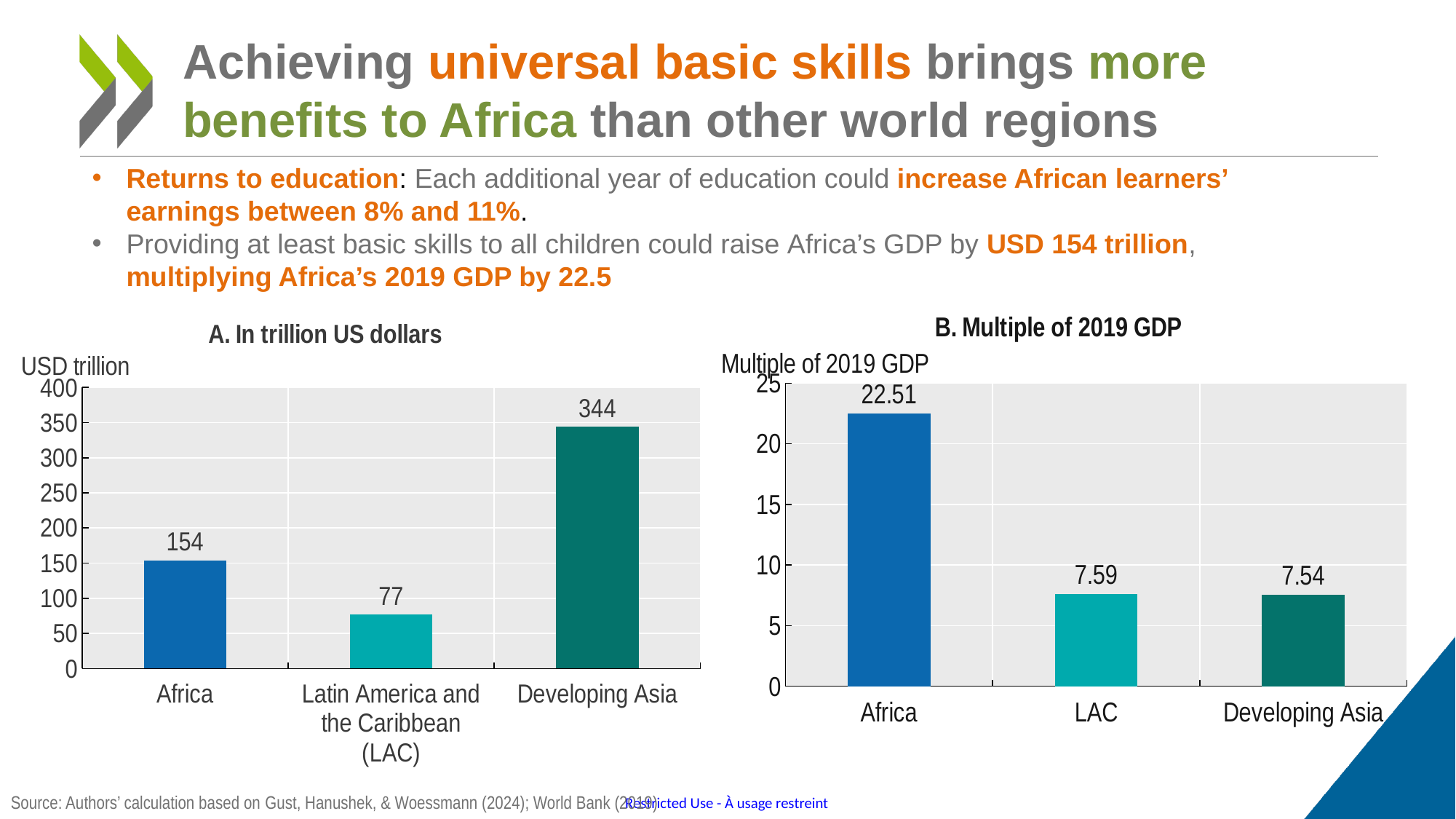
In chart A (In trillion US dollars), what is the value for Developing Asia? 344 In chart B (Multiple of 2019 GDP), what is the value for LAC? 7.59 In chart A (In trillion US dollars), what is the value for Africa? 154 In chart A (In trillion US dollars), which region has the lowest value? Latin America and the Caribbean (LAC) In chart A (In trillion US dollars), how many regions are shown? 3 What is the axis label shown above the y axis of chart B? Multiple of 2019 GDP In chart A (In trillion US dollars), what is the difference between Developing Asia and Africa? 190 What kind of chart is chart A (In trillion US dollars)? Bar chart In chart B (Multiple of 2019 GDP), what is the value for Africa? 22.51 In chart B (Multiple of 2019 GDP), which region has the highest value? Africa In chart B (Multiple of 2019 GDP), is the value for Africa greater or less than 20? greater In chart B (Multiple of 2019 GDP), what is the difference between Africa and Developing Asia? 14.97